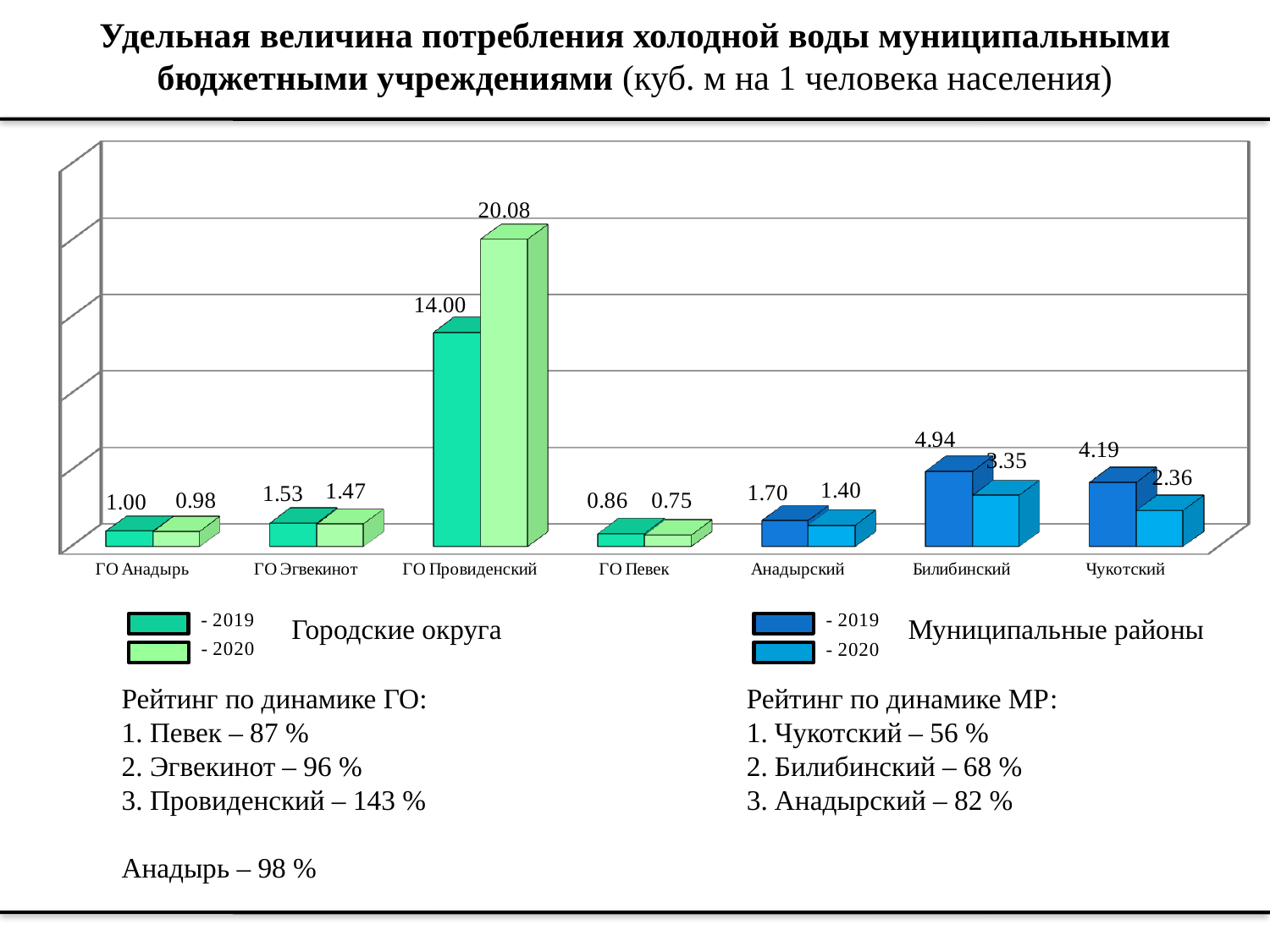
What is the 2019 value for Анадырский? 1.70 What is the 2020 value for ГО Провиденский? 20.08 What type of chart is shown on the slide? Bar chart Which category has the highest 2020 value? ГО Провиденский Which is larger for Билибинский: the 2019 value or the 2020 value? 2019 How many categories are shown on the x axis of the chart? 7 What is the 2019 value for Билибинский? 4.94 What is the difference between the 2020 and 2019 values for ГО Провиденский? 6.08 How many series does the left (Городские округа) legend list? 2 What is the difference between the 2019 and 2020 values for Чукотский? 1.83 Which category has the lowest 2019 value? ГО Певек What is the 2020 value for ГО Певек? 0.75